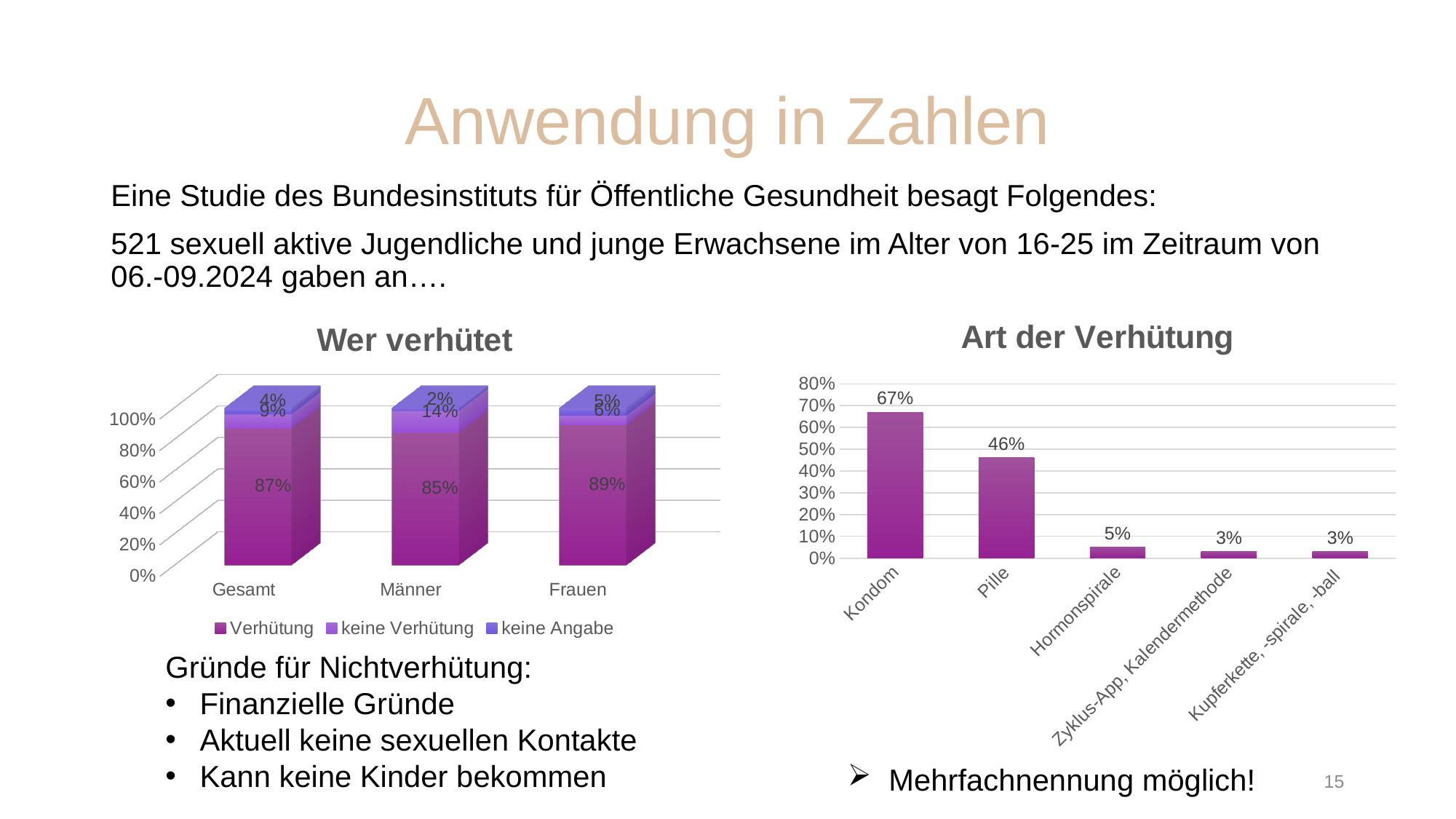
In the 'Art der Verhütung' chart, what is the value for Kondom? 67% In the 'Wer verhütet' chart, what is the 'Verhütung' value for Frauen? 89% In the 'Wer verhütet' chart, what is the 'keine Verhütung' value for Männer? 14% In the 'Art der Verhütung' chart, what is the value for Pille? 46% In the 'Art der Verhütung' chart, how many categories are shown? 5 In the 'Wer verhütet' chart, which category has the highest 'Verhütung' value? Frauen In the 'Wer verhütet' chart, how many series does the legend list? 3 In the 'Art der Verhütung' chart, which category has the highest value? Kondom In the 'Art der Verhütung' chart, what is the value for Hormonspirale? 5% In the 'Art der Verhütung' chart, what is the difference between the values for Kondom and Pille? 21% In the 'Wer verhütet' chart, is the 'Verhütung' value for Männer larger or smaller than that for Frauen? Smaller What kind of chart is 'Art der Verhütung'? Bar chart